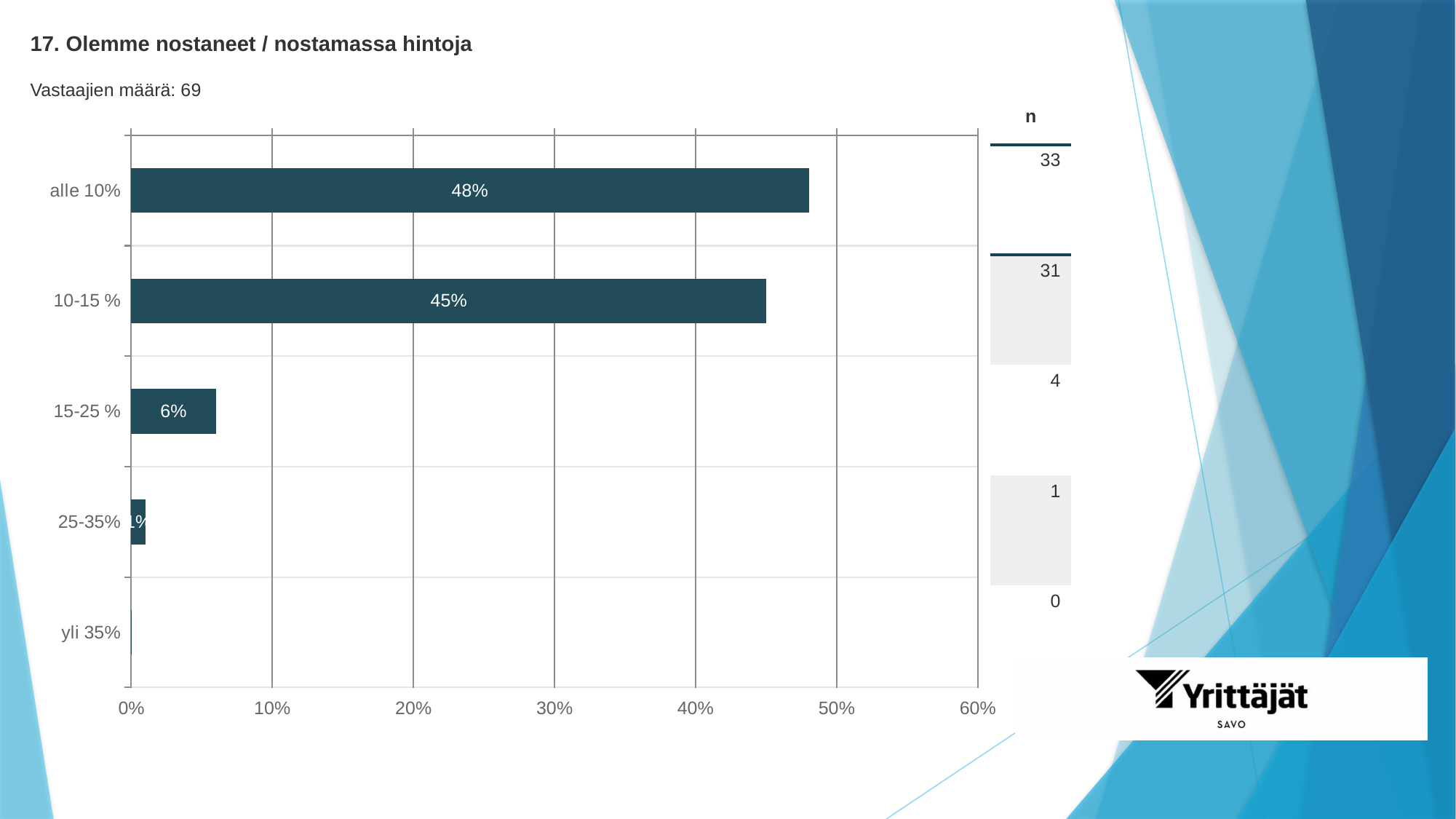
Which is larger, the percentage for '15-25 %' or for '25-35%'? 15-25 % What percentage is shown for the category 'alle 10%'? 48% What is the difference in percentage points between 'alle 10%' and '10-15 %'? 3 Which category has the highest percentage? alle 10% What is the n value listed for the category 'yli 35%'? 0 What percentage is shown for the category '15-25 %'? 6% How many categories are shown on the chart? 5 What is the n value listed for the category '10-15 %'? 31 Which category has the lowest percentage? yli 35% What percentage is shown for the category '10-15 %'? 45% What kind of chart is shown on the slide? Bar chart How many respondents (Vastaajien määrä) are stated on the slide? 69